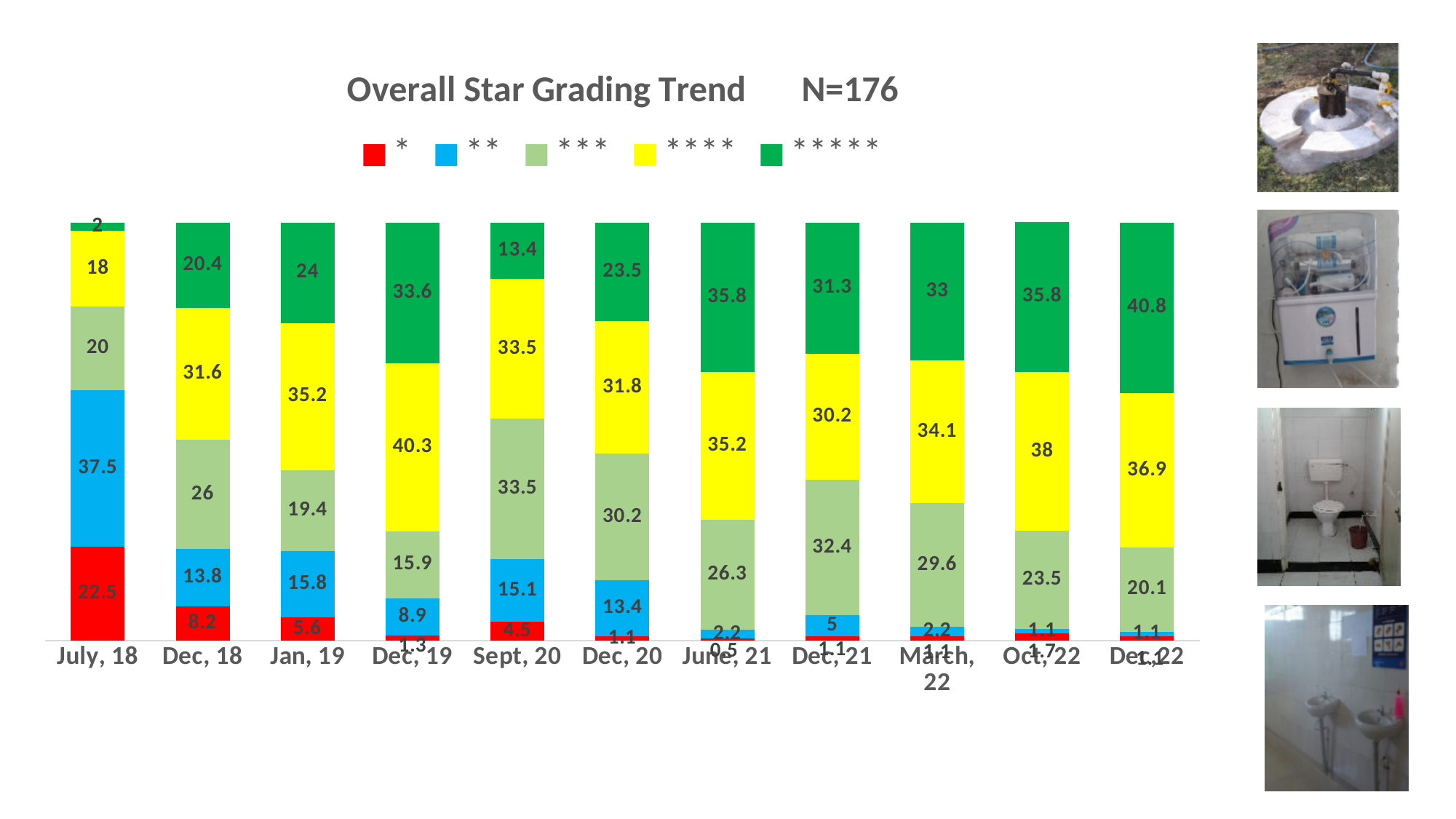
What is the value of the *** (three-star) segment for Sept, 20? 33.5 How many series does the legend list? 5 Which period has the larger **** (four-star) value, Oct, 22 or Dec, 22? Oct, 22 What kind of chart is shown on the slide? Stacked bar chart How many time periods are shown along the x axis? 11 Does the * (one-star) series generally rise or fall from July, 18 to Oct, 22? Fall What is the value of the * (one-star) segment for Dec, 18? 8.2 What is the value of the ** (two-star) segment for July, 18? 37.5 Which period has the highest ***** (five-star) value? Dec, 22 What is the value of the ***** (five-star) segment for Dec, 22? 40.8 What is the difference between the ***** (five-star) value for Dec, 22 and for July, 18? 38.8 Which period has the lowest ***** (five-star) value? July, 18